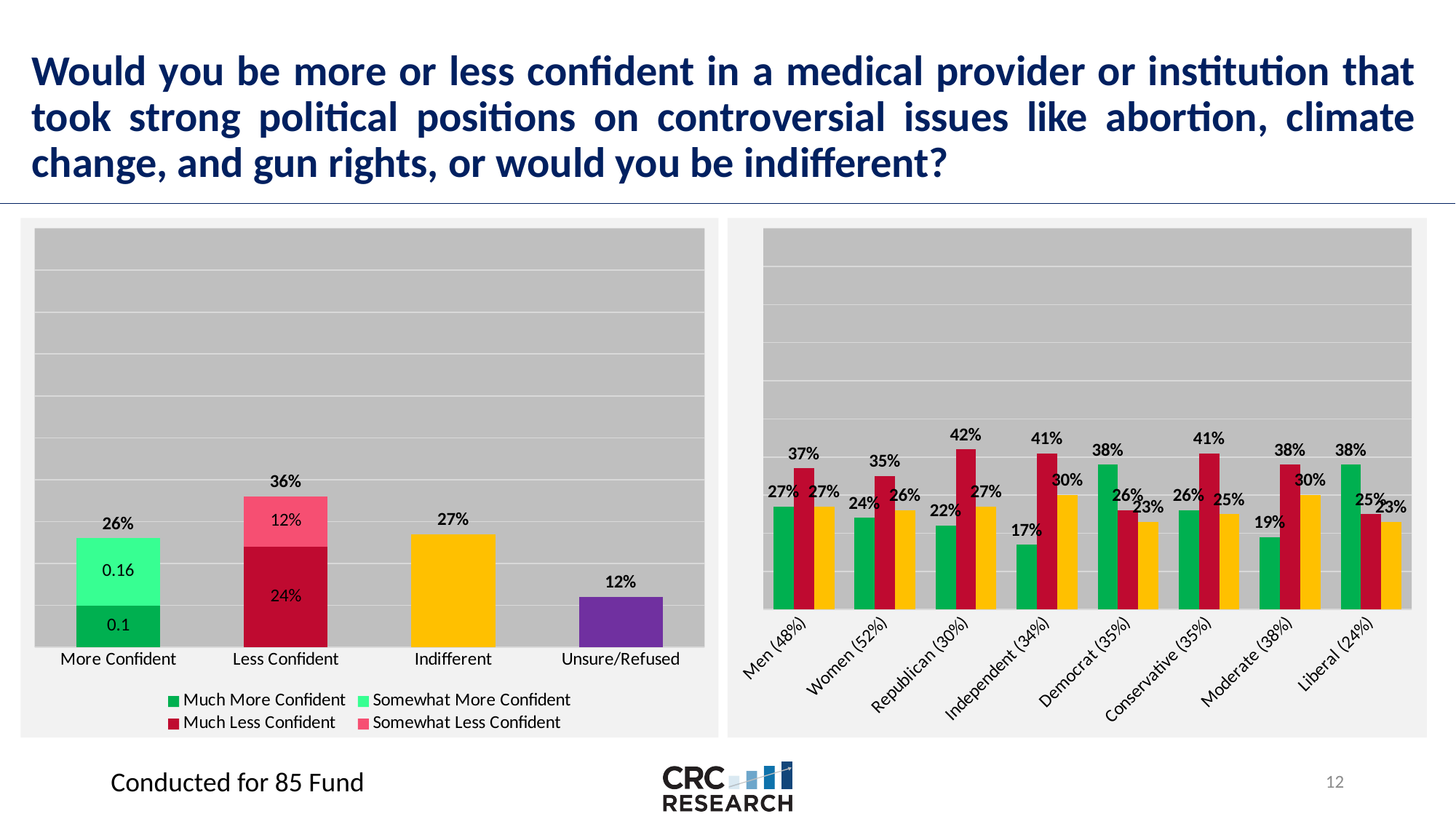
In the right chart, is the red bar for Men (48%) larger or smaller than the red bar for Women (52%)? larger In the right chart, what is the value of the red bar for Republican (30%)? 42% In the left chart, what is the value of the Somewhat More Confident segment of the More Confident bar? 0.16 In the left chart, what is the total value shown for the Less Confident bar? 36% In the right chart, what is the value of the green bar for Independent (34%)? 17% In the left chart, what is the value of the Much Less Confident segment of the Less Confident bar? 24% In the left chart, what is the difference between the Indifferent value and the Unsure/Refused value? 15% In the right chart, how many groups are shown on the x axis? 8 In the left chart, which category has the highest total value? Less Confident In the right chart, which group has the highest green bar value? Democrat (35%) and Liberal (24%), both 38% In the left chart, how many series does the legend list? 4 In the left chart, which category has the lowest value? Unsure/Refused